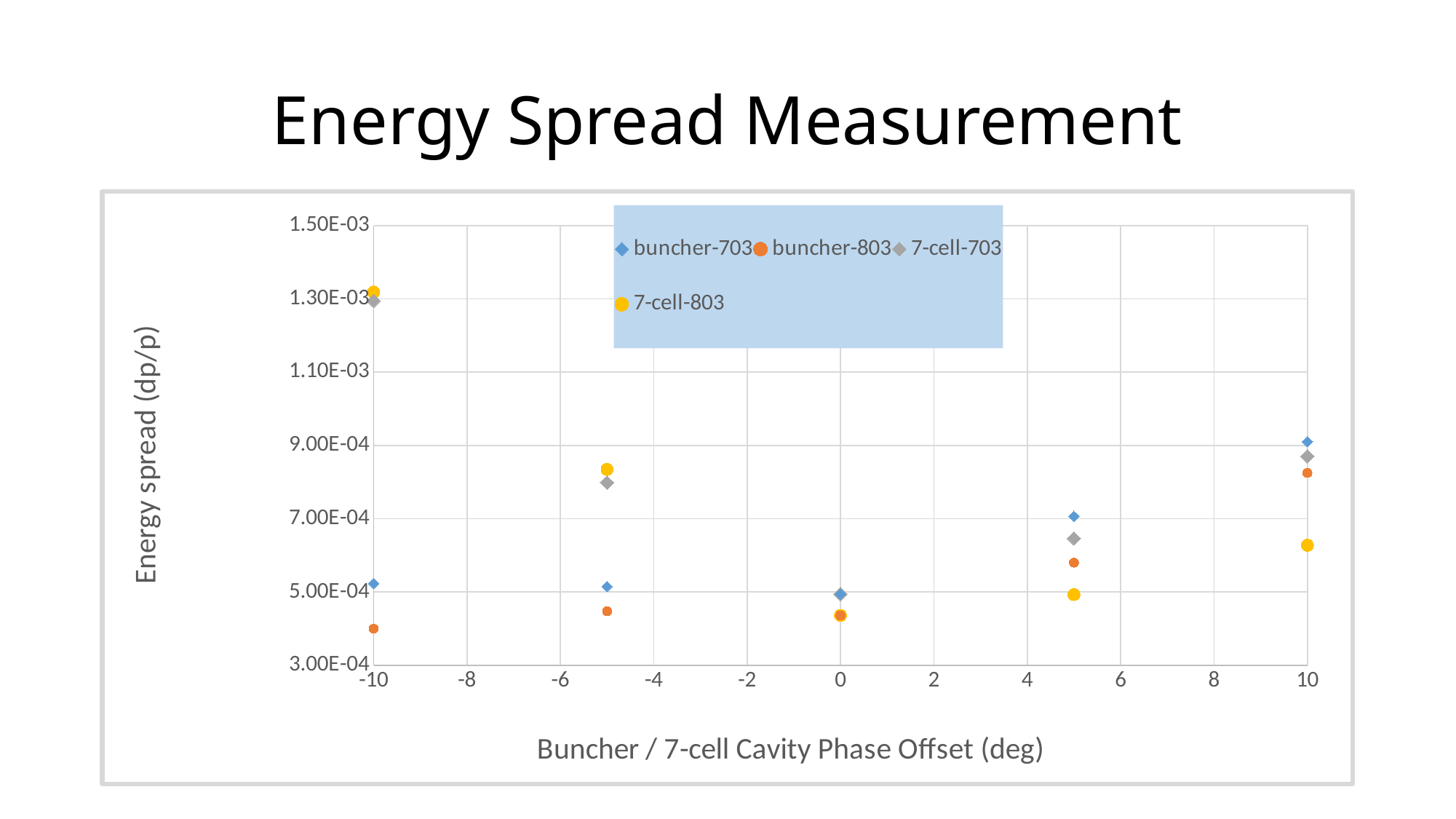
Is the value for buncher-803 at a phase offset of -10 greater or less than 5.00E-04? less Which series has the highest energy spread at a phase offset of 5? buncher-703 At a phase offset of 10, which is larger: buncher-703 or 7-cell-803? buncher-703 What is the x-axis title of the chart? Buncher / 7-cell Cavity Phase Offset (deg) Does the energy spread for 7-cell-803 rise or fall as the phase offset goes from -10 to 0? fall How many phase offset values are plotted for each series? 5 What kind of chart is shown on the slide? scatter chart Is the value for buncher-703 at a phase offset of 10 greater or less than 7.00E-04? greater Is the value for 7-cell-803 at a phase offset of -10 greater or less than 1.10E-03? greater At a phase offset of -5, which is larger: 7-cell-803 or buncher-803? 7-cell-803 How many series does the legend list? 4 Which series has the lowest energy spread at a phase offset of 10? 7-cell-803